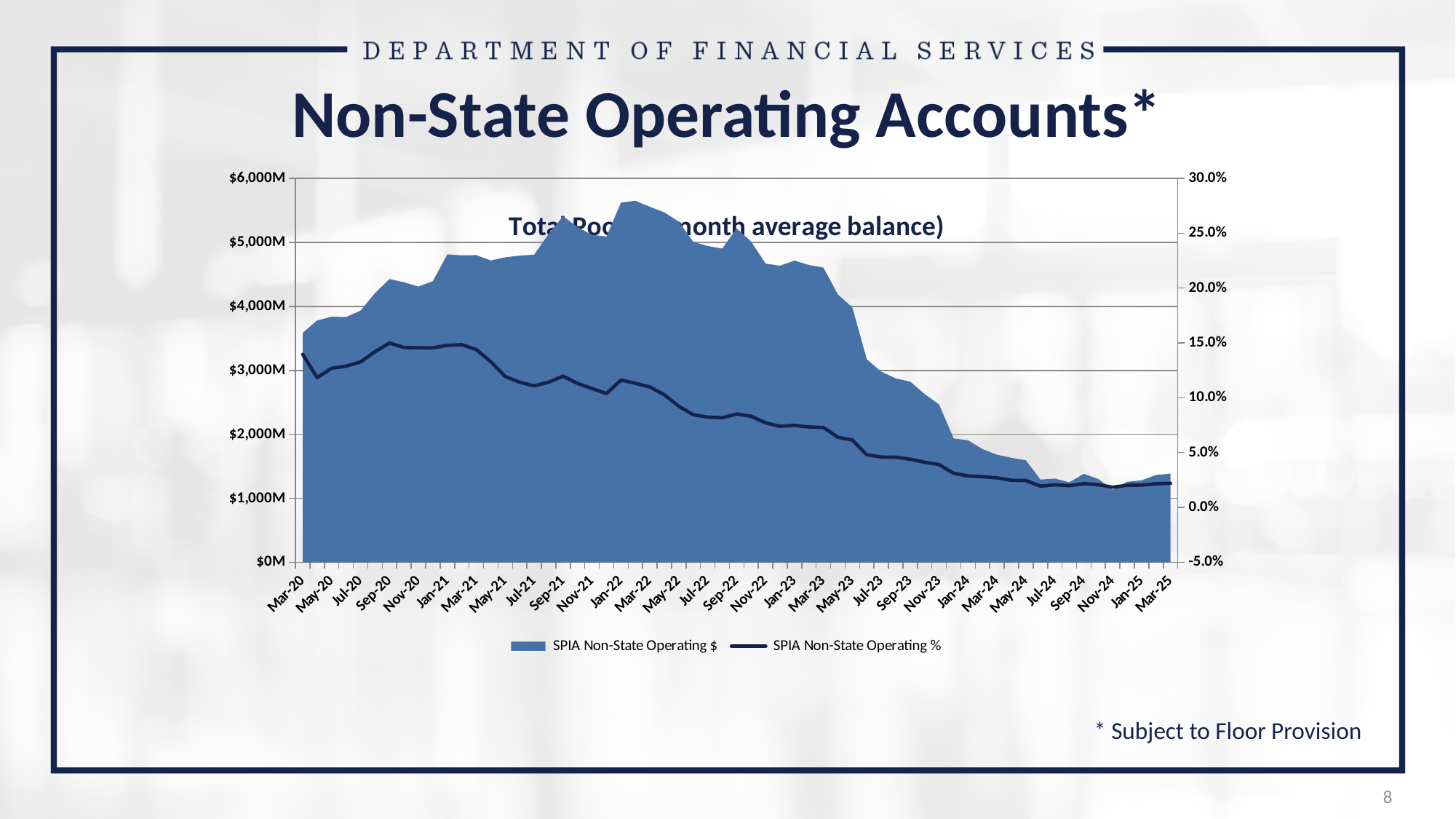
How many series does the legend list? 2 Is the SPIA Non-State Operating $ value for Mar-25 greater or less than $2,000M? less Is the SPIA Non-State Operating % value for Mar-25 greater or less than 5.0%? less What are the two series named in the legend? SPIA Non-State Operating $ and SPIA Non-State Operating % Is the SPIA Non-State Operating % value for Sep-22 greater or less than 10.0%? less What kind of chart is shown on the slide? A combined area and line chart Which is larger, the SPIA Non-State Operating $ value for Mar-20 or for Mar-25? Mar-20 Does the SPIA Non-State Operating $ value rise or fall from Mar-22 to Mar-25? fall Which series is drawn as a dark line rather than a shaded area? SPIA Non-State Operating % Around which month does the SPIA Non-State Operating $ area reach its highest point? Feb-22